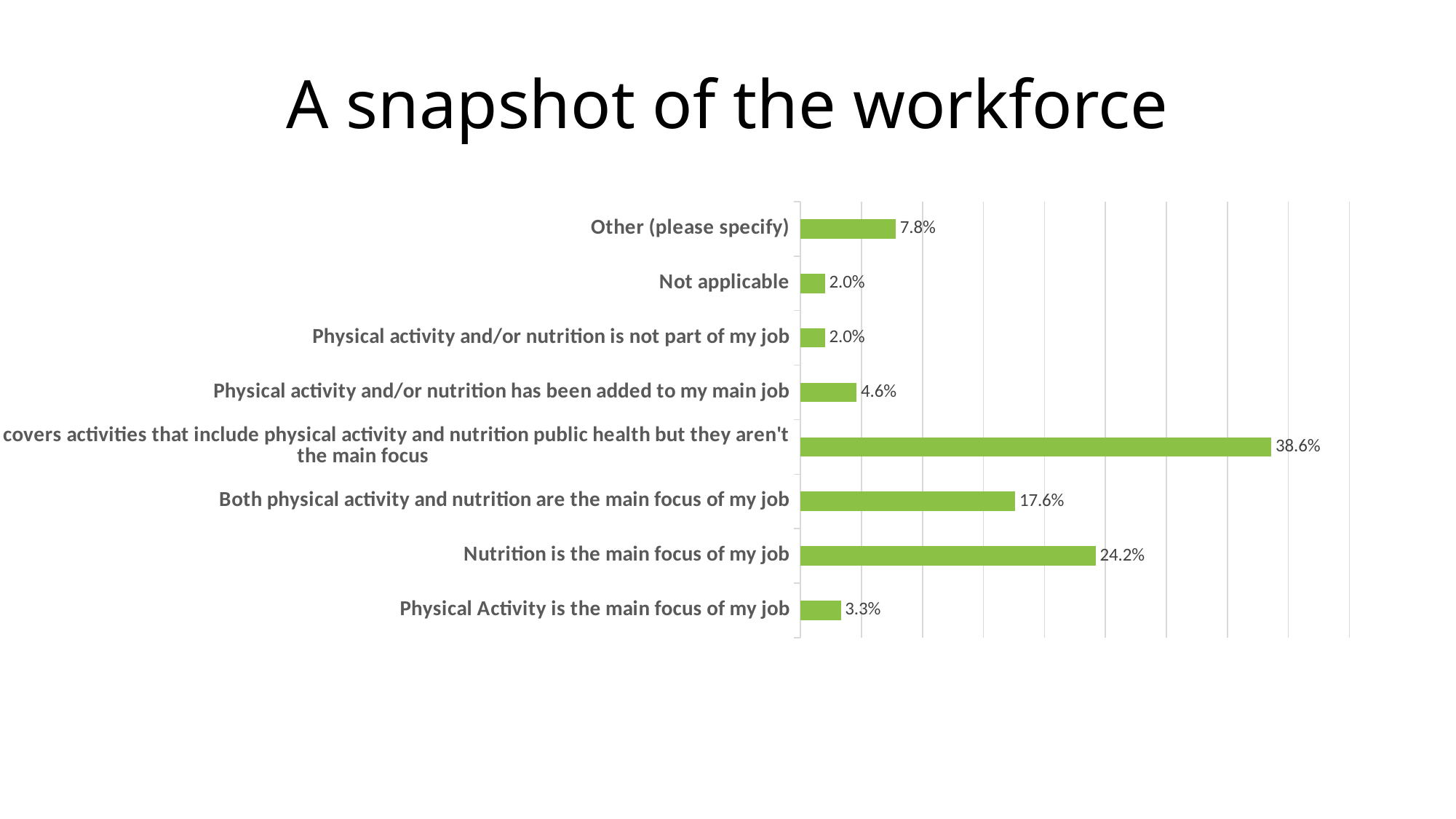
What is the value for 'Other (please specify)'? 7.8% What is the value for 'Both physical activity and nutrition are the main focus of my job'? 17.6% What is the difference between 'Nutrition is the main focus of my job' and 'Both physical activity and nutrition are the main focus of my job'? 6.6% What is the title of the slide? A snapshot of the workforce What kind of chart is shown on the slide? Bar chart What is the value for 'Physical Activity is the main focus of my job'? 3.3% Which category has the highest value? covers activities that include physical activity and nutrition public health but they aren't the main focus How many categories are shown in the chart? 8 Which is larger: 'Other (please specify)' or 'Physical activity and/or nutrition has been added to my main job'? Other (please specify) What is the value for 'Physical activity and/or nutrition has been added to my main job'? 4.6% What is the difference between the highest value and 'Nutrition is the main focus of my job'? 14.4% What is the value for 'Nutrition is the main focus of my job'? 24.2%